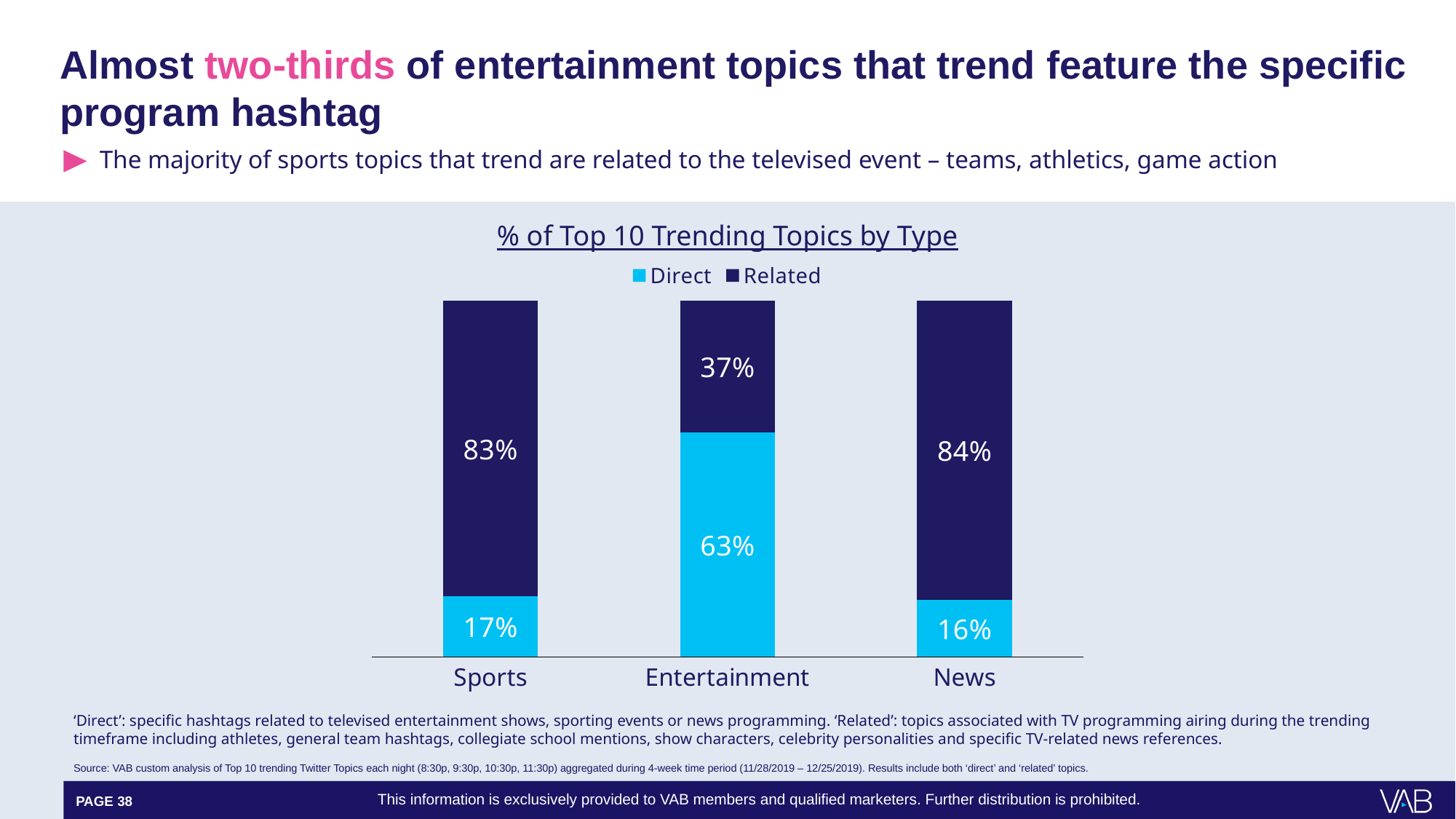
How many categories are shown on the x axis? 3 What is the Direct value for Sports? 17% What is the Related value for Entertainment? 37% What is the difference between the Direct values for Entertainment and Sports? 46% What kind of chart is shown? Stacked bar chart Which category has the highest Direct value? Entertainment What is the Related value for News? 84% How many series does the legend list? 2 What is the title of the chart? % of Top 10 Trending Topics by Type Which category has the lowest Direct value? News What is the Direct value for Entertainment? 63% Which is larger, the Related value for Sports or the Related value for Entertainment? Sports